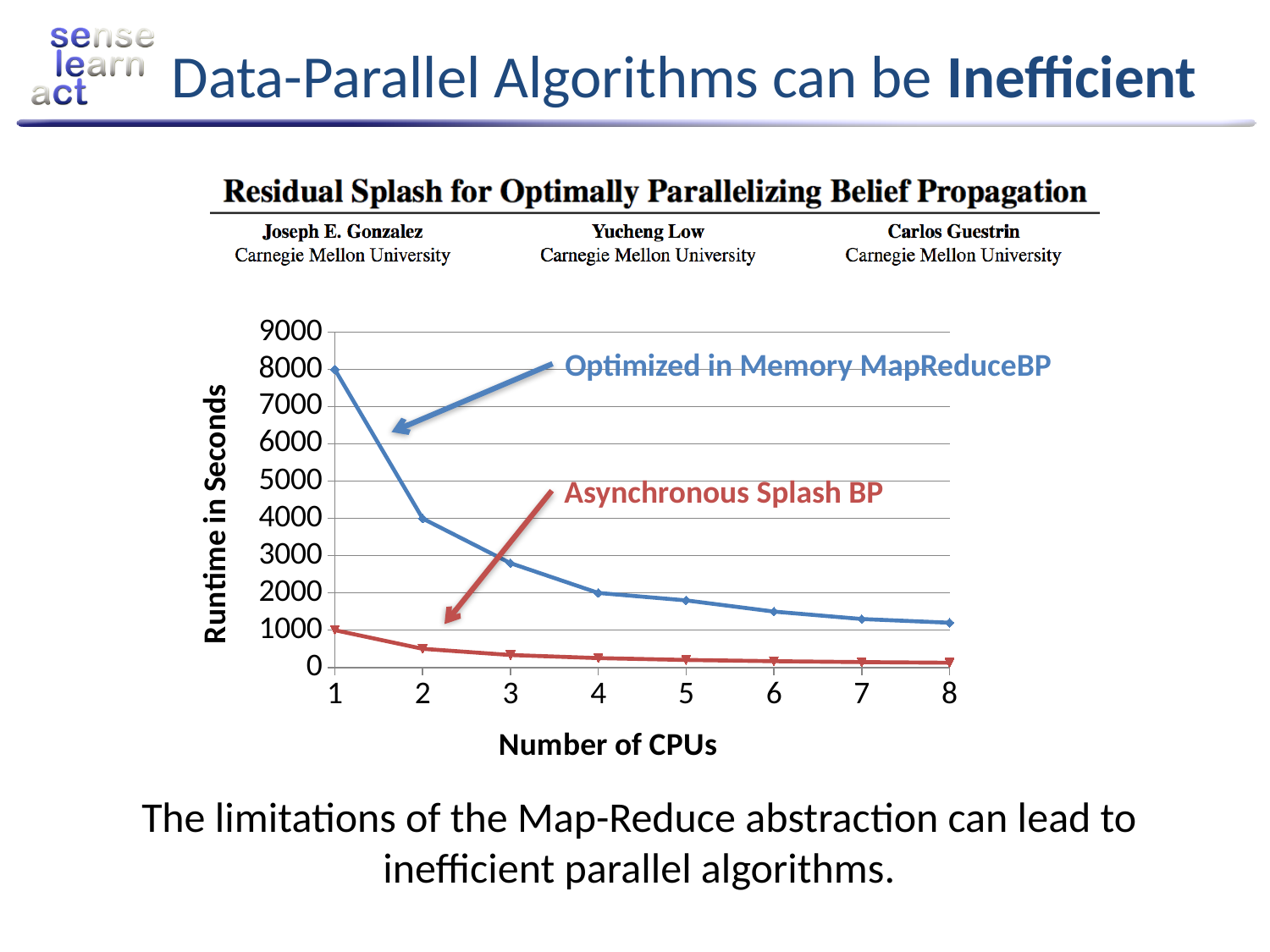
Which series is drawn in red? Asynchronous Splash BP How many series are plotted on the chart? 2 Is the runtime of Asynchronous Splash BP at 8 CPUs greater or less than 1000? less What is the runtime of Asynchronous Splash BP at 1 CPU? 1000 Is the runtime of Optimized in Memory MapReduceBP at 3 CPUs greater or less than 2000? greater Which series has the higher runtime at 4 CPUs, Optimized in Memory MapReduceBP or Asynchronous Splash BP? Optimized in Memory MapReduceBP How many points along the x axis (Number of CPUs) does each line have? 8 What is the runtime of Optimized in Memory MapReduceBP at 1 CPU? 8000 Does the runtime of Optimized in Memory MapReduceBP rise or fall as the number of CPUs increases? fall What kind of chart is shown on the slide? line chart What is the label of the y axis? Runtime in Seconds